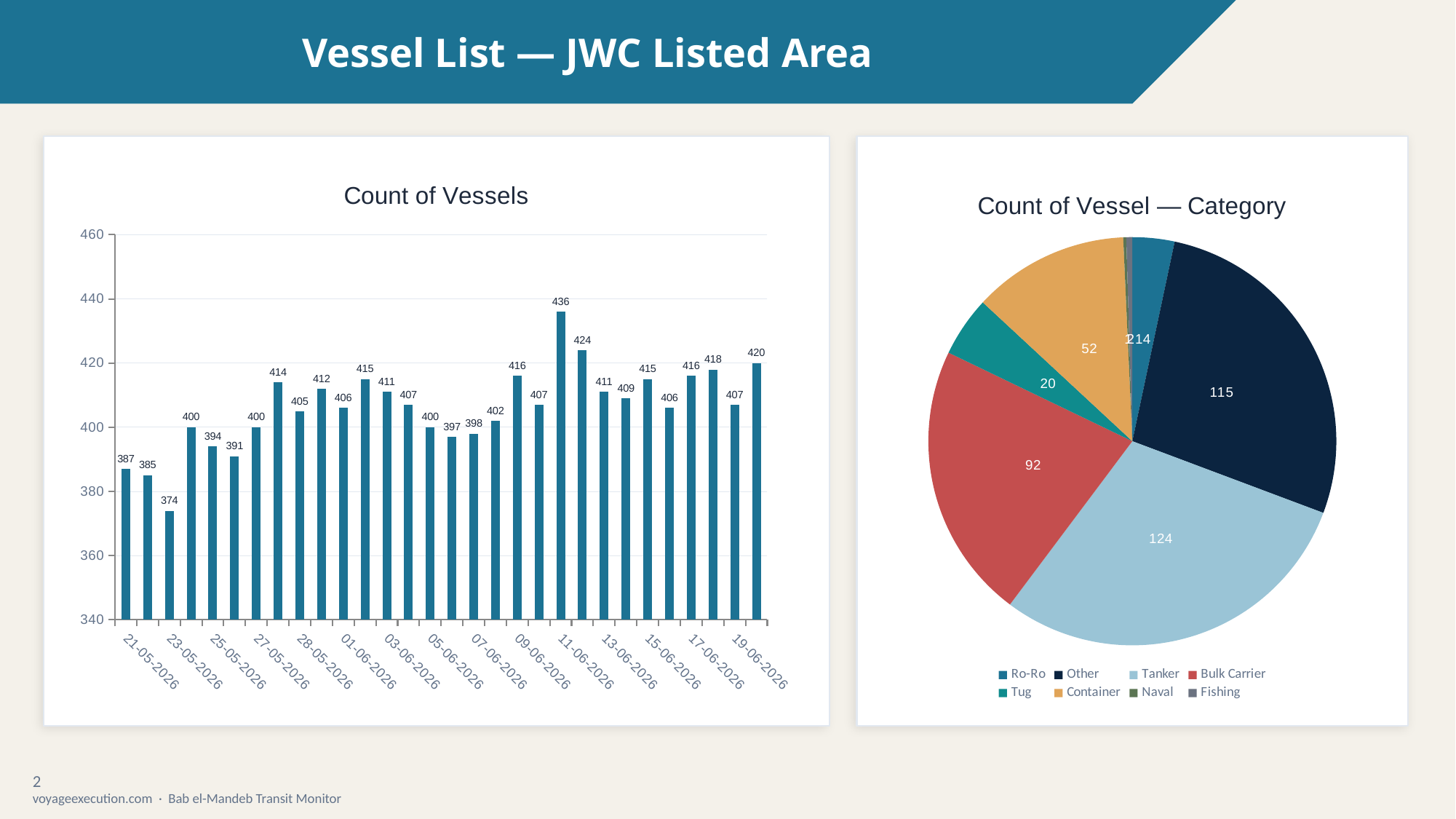
On the Count of Vessel — Category pie chart, what is the value for Tanker? 124 On the Count of Vessel — Category pie chart, what is the value for Bulk Carrier? 92 On the Count of Vessels bar chart, what is the value for 21-05-2026? 387 On the Count of Vessel — Category pie chart, which is larger, Container or Tug? Container How many categories does the legend of the Count of Vessel — Category pie chart list? 8 How many bars are plotted on the Count of Vessels chart? 30 What kind of chart is the Count of Vessels chart? bar chart On the Count of Vessels bar chart, what is the lowest value shown? 374 On the Count of Vessel — Category pie chart, which category has the largest slice? Tanker On the Count of Vessels bar chart, what is the highest value shown? 436 On the Count of Vessels bar chart, what is the difference between the highest value (436) and the lowest value (374)? 62 On the Count of Vessel — Category pie chart, what is the difference between Tanker and Other? 9